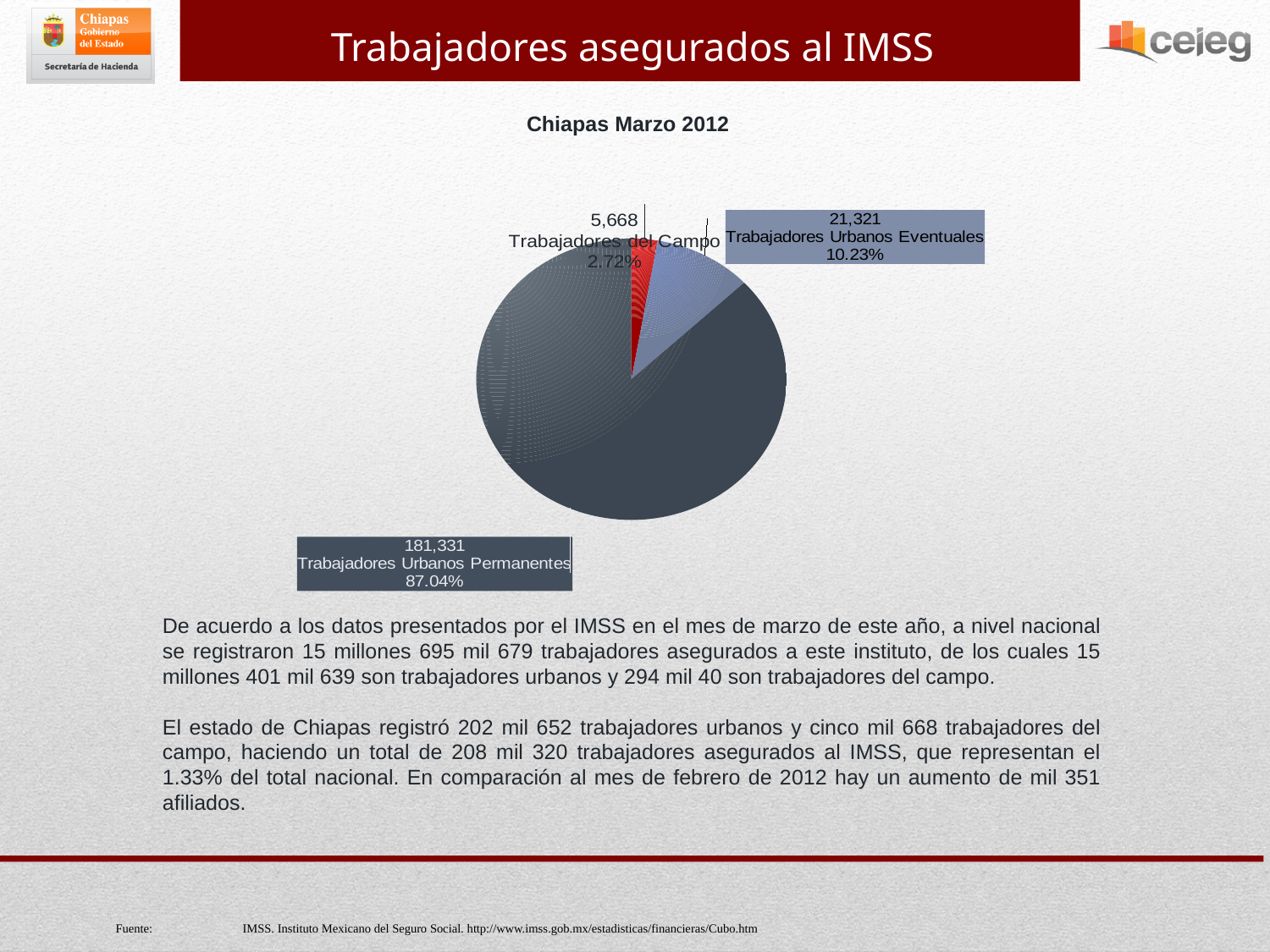
What share of the pie does Trabajadores del Campo represent? 2.72% What is the value for Trabajadores Urbanos Permanentes? 181,331 What kind of chart is shown on the slide? Pie chart How many slices does the pie chart have? 3 What is the difference between the values for Trabajadores Urbanos Eventuales and Trabajadores del Campo? 15,653 What is the value for Trabajadores Urbanos Eventuales? 21,321 Which category has the smallest slice of the pie? Trabajadores del Campo What share of the pie does Trabajadores Urbanos Eventuales represent? 10.23% What is the title shown above the pie chart? Chiapas Marzo 2012 Which category has the largest slice of the pie? Trabajadores Urbanos Permanentes What is the value for Trabajadores del Campo? 5,668 What share of the pie does Trabajadores Urbanos Permanentes represent? 87.04%